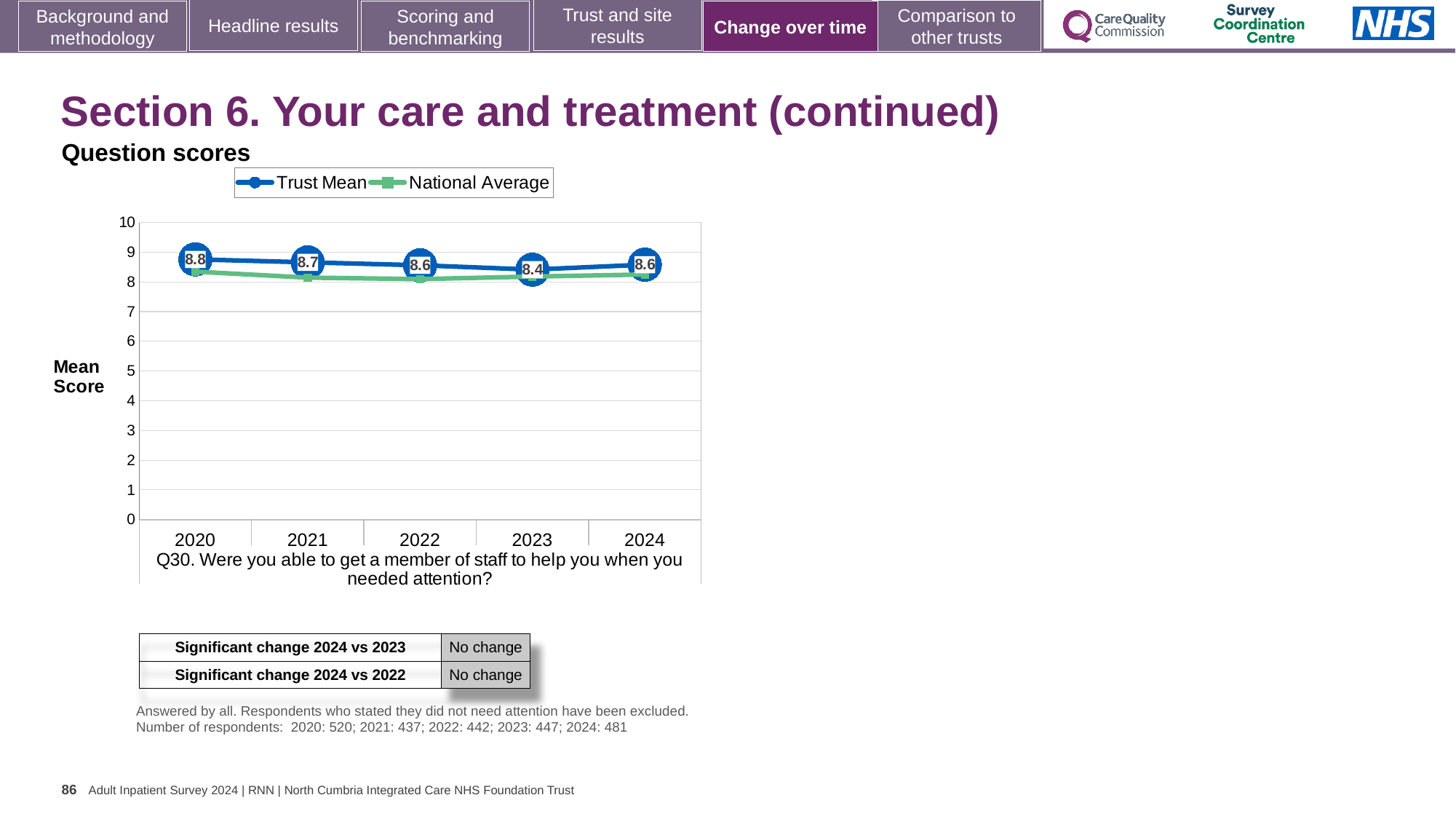
What kind of chart is shown on the slide? Line chart In which year is the Trust Mean score highest? 2020 What is the Trust Mean score for 2020? 8.8 How many years are plotted on the x axis of the chart? 5 What is the Trust Mean score for 2024? 8.6 How many series does the chart legend list? 2 Does the Trust Mean score rise or fall from 2020 to 2023? Fall Which is larger, the Trust Mean score in 2021 or in 2024? 2021 Is the National Average value for 2022 greater or less than 9? less What is the Trust Mean score for 2023? 8.4 In which year is the Trust Mean score lowest? 2023 What is the difference between the Trust Mean score in 2020 and in 2023? 0.4